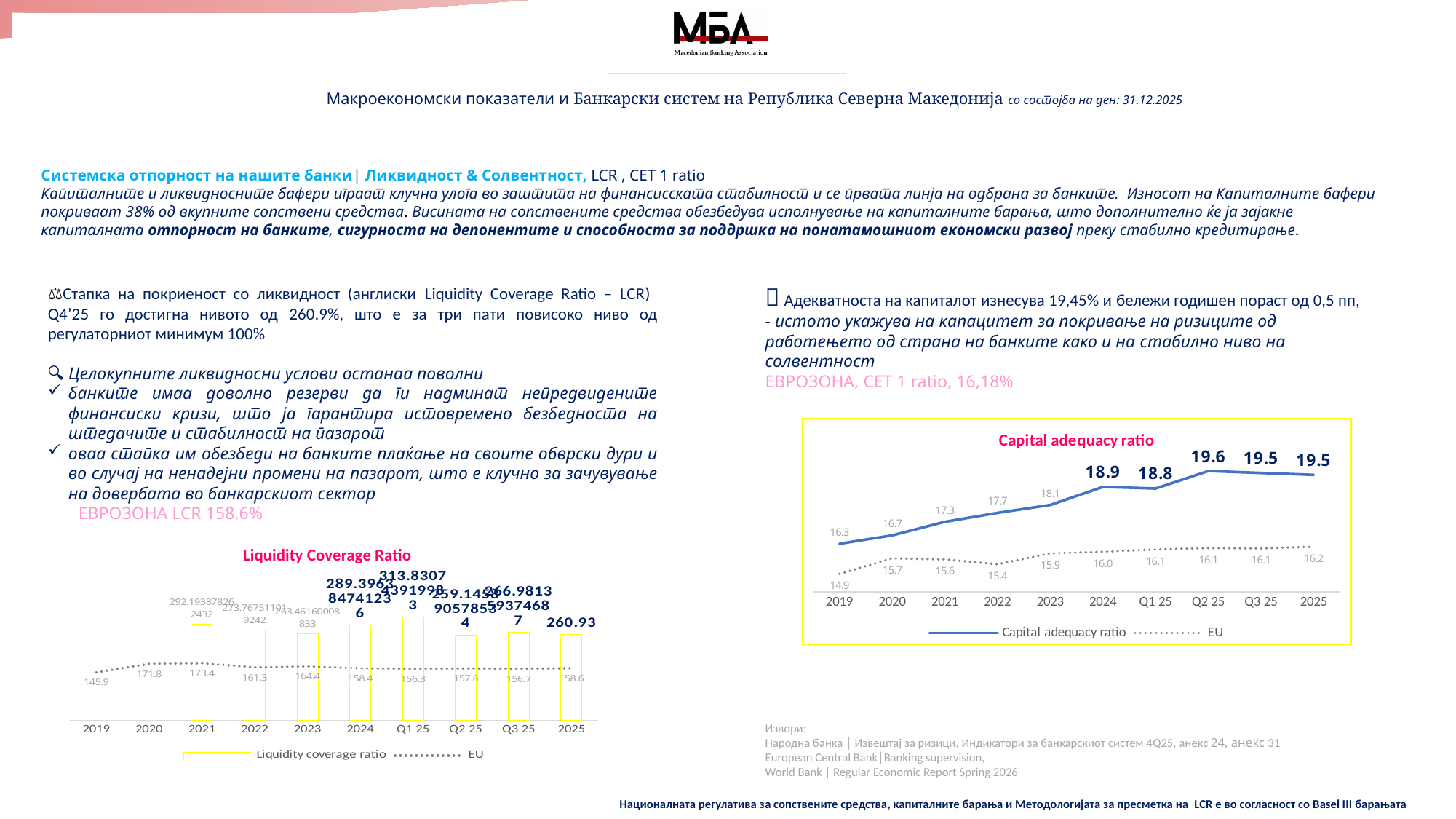
In the Capital adequacy ratio chart, what is the Capital adequacy ratio value for Q2 25? 19.6 In the Capital adequacy ratio chart, what is the Capital adequacy ratio value for 2019? 16.3 How many series does the legend of the Capital adequacy ratio chart list? 2 How many periods are shown on the x axis of the Liquidity Coverage Ratio chart? 10 In the Liquidity Coverage Ratio chart, which period has the highest EU value? 2021 In the Liquidity Coverage Ratio chart, what is the EU value for 2019? 145.9 In the Capital adequacy ratio chart, what is the difference between the Capital adequacy ratio and the EU value in 2025? 3.3 In the Capital adequacy ratio chart, does the Capital adequacy ratio generally rise or fall from 2019 to 2025? rise In the Liquidity Coverage Ratio chart, what is the Liquidity coverage ratio value for 2025? 260.93 In the Capital adequacy ratio chart, what is the EU value for 2025? 16.2 In the Capital adequacy ratio chart, which period has the lowest EU value? 2019 In the Capital adequacy ratio chart, which period has the highest Capital adequacy ratio? Q2 25